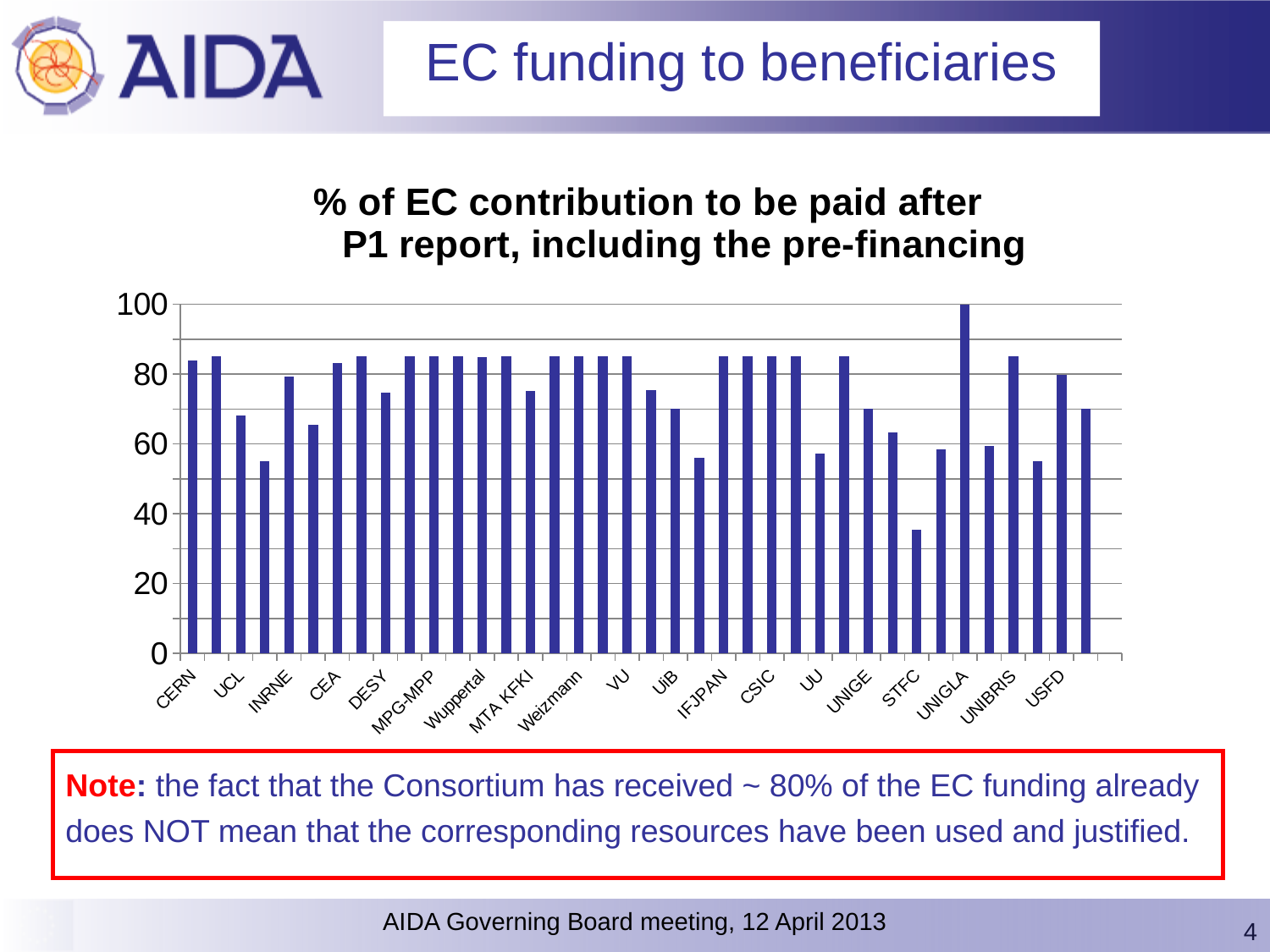
Is the value for CERN greater or less than 80? greater Is the value for UCL greater or less than 80? less Is the value for UNIGE greater or less than 80? less What is the title of the chart? % of EC contribution to be paid after P1 report, including the pre-financing Which has the larger value, CERN or UCL? CERN What is the highest value reached by any bar in the chart? 100 Which has the larger value, Weizmann or UNIGE? Weizmann What is the maximum value shown on the vertical axis? 100 What kind of chart is shown on the slide? bar chart